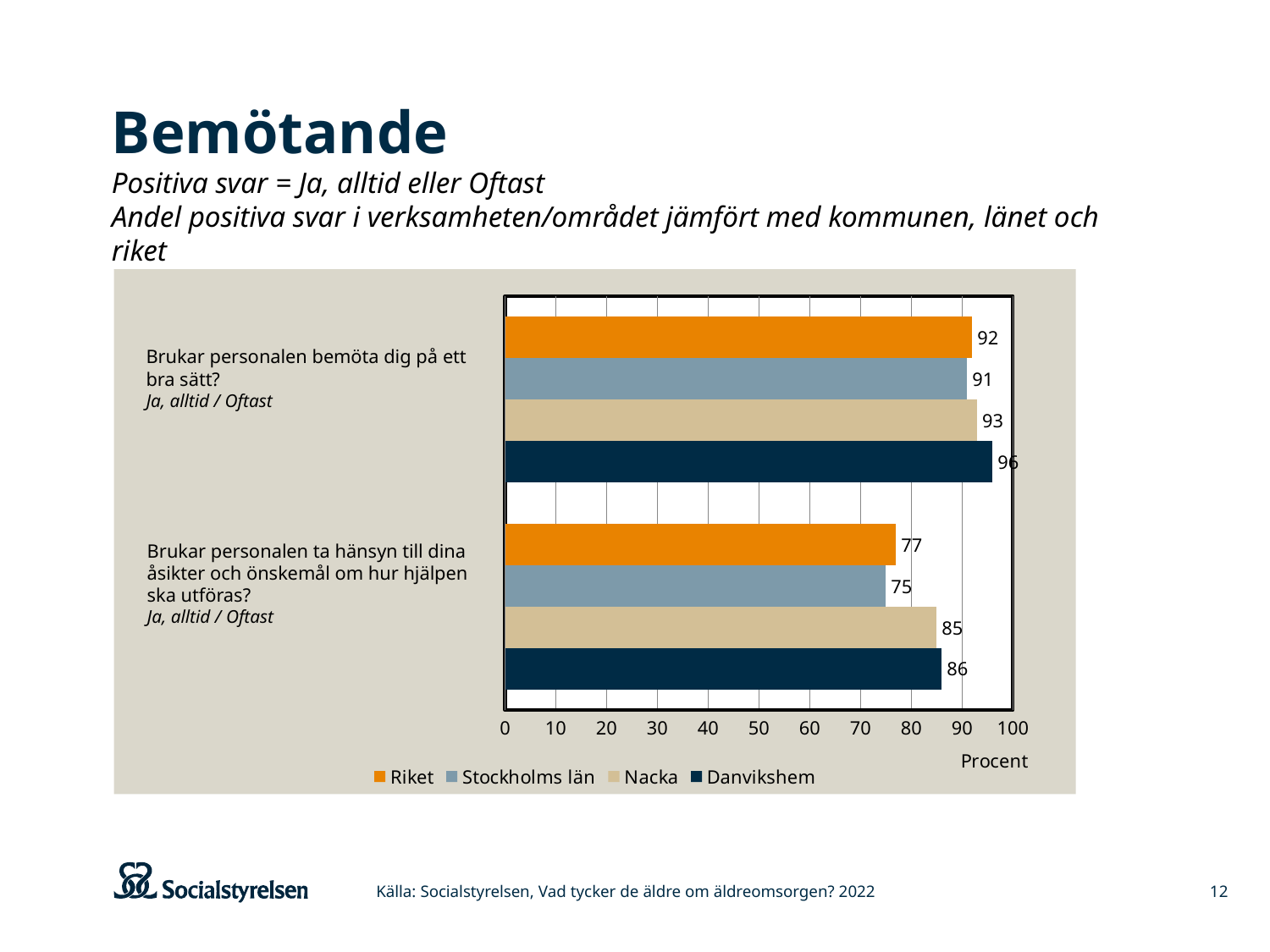
What is the difference between the Nacka and Stockholms län values on the question 'Brukar personalen bemöta dig på ett bra sätt?' 2 What value is shown for Danvikshem on the question 'Brukar personalen bemöta dig på ett bra sätt?' 96 Which series has the lowest value on the question 'Brukar personalen bemöta dig på ett bra sätt?' Stockholms län What kind of chart is shown on the slide? Bar chart Which is larger on the question 'Brukar personalen ta hänsyn till dina åsikter och önskemål om hur hjälpen ska utföras?': the value for Riket or the value for Nacka? Nacka How many series does the legend list? 4 Which series has the highest value on the question 'Brukar personalen ta hänsyn till dina åsikter och önskemål om hur hjälpen ska utföras?' Danvikshem What value is shown for Stockholms län on the question 'Brukar personalen ta hänsyn till dina åsikter och önskemål om hur hjälpen ska utföras?' 75 What is the label on the horizontal axis of the chart? Procent What is the difference between the Danvikshem and Riket values on the question 'Brukar personalen ta hänsyn till dina åsikter och önskemål om hur hjälpen ska utföras?' 9 What value is shown for Nacka on the question 'Brukar personalen ta hänsyn till dina åsikter och önskemål om hur hjälpen ska utföras?' 85 What value is shown for Riket on the question 'Brukar personalen bemöta dig på ett bra sätt?' 92